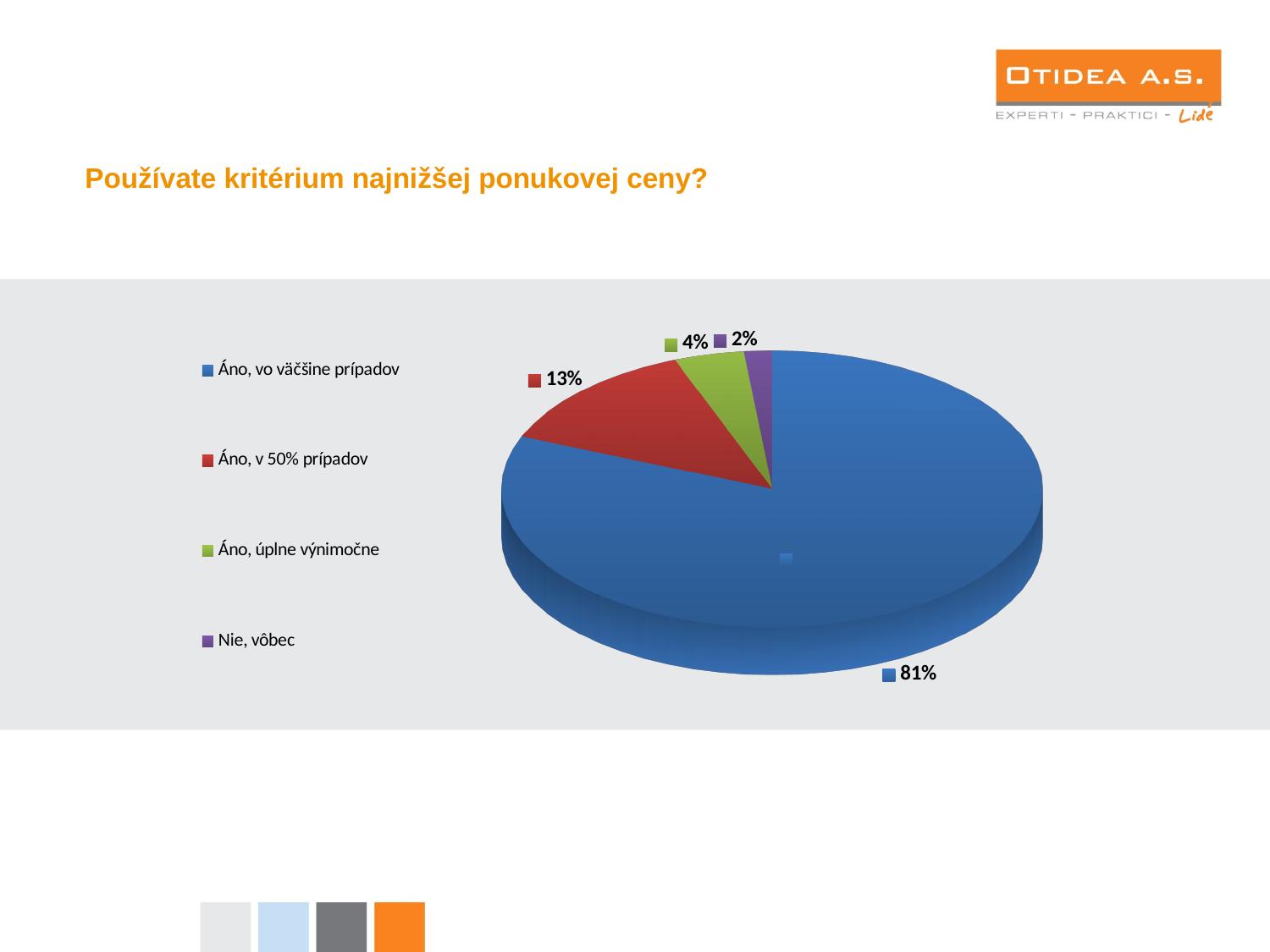
What is the value shown for "Áno, v 50% prípadov"? 13% What kind of chart is shown on the slide? Pie chart What is the difference between the values for "Áno, úplne výnimočne" and "Nie, vôbec"? 2% Which is larger, the value for "Áno, v 50% prípadov" or the value for "Áno, úplne výnimočne"? Áno, v 50% prípadov What is the value shown for "Nie, vôbec"? 2% Which category has the smallest slice of the pie? Nie, vôbec What is the value shown for "Áno, úplne výnimočne"? 4% How many categories does the pie chart show? 4 Which category has the largest slice of the pie? Áno, vo väčšine prípadov What is the difference between the values for "Áno, vo väčšine prípadov" and "Áno, v 50% prípadov"? 68% What colour is the slice for "Nie, vôbec"? Purple What share of the pie does "Áno, vo väčšine prípadov" represent? 81%